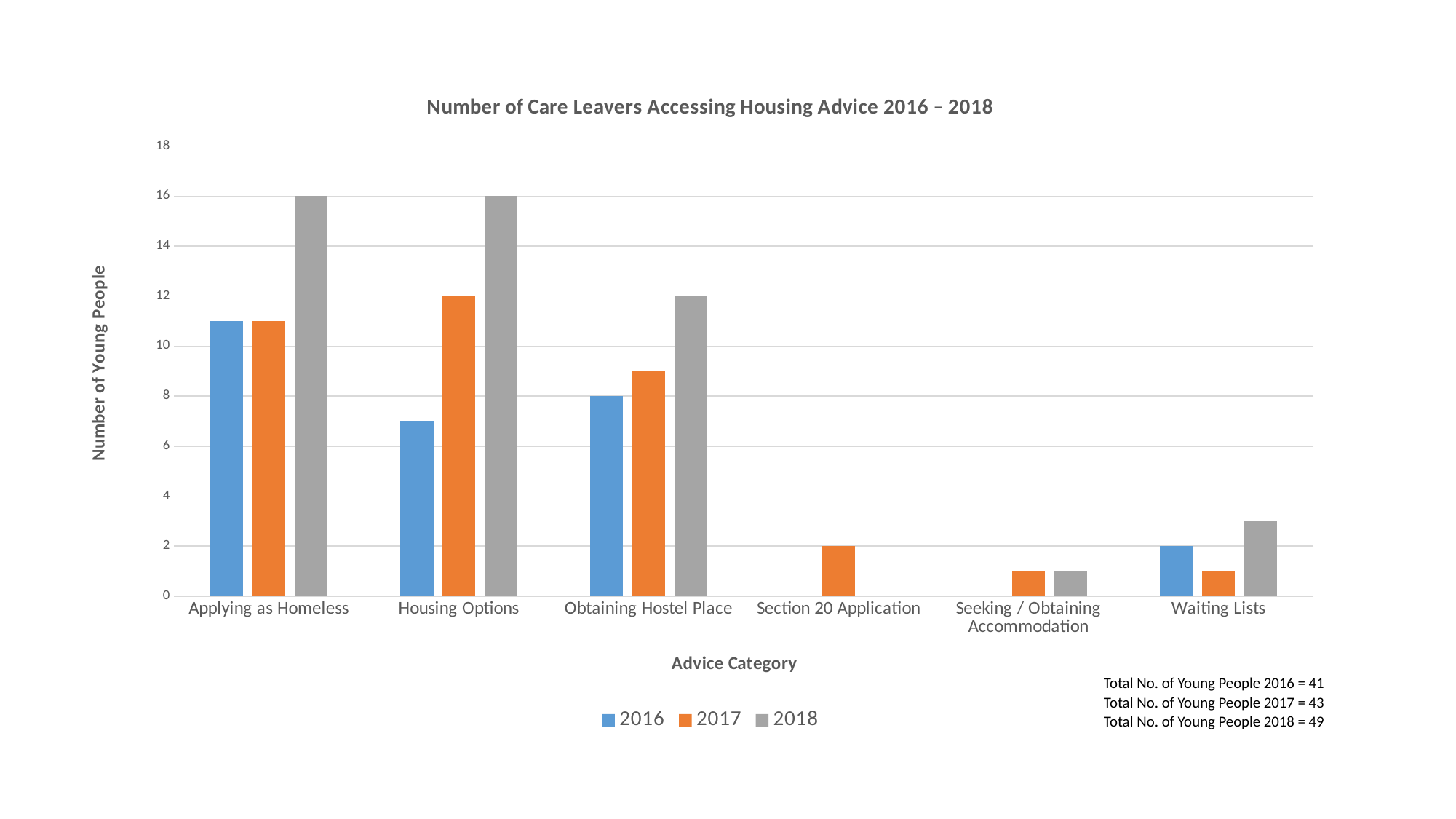
How many advice categories are shown on the x axis? 6 What is the value for 2017 in the Housing Options category? 12 Which year has the lowest value in the Obtaining Hostel Place category? 2016 What is the difference between the 2018 and 2016 values in the Obtaining Hostel Place category? 4 Which year has the highest value in the Housing Options category? 2018 What is the value for 2017 in the Section 20 Application category? 2 Is the value for 2018 in the Waiting Lists category greater or less than 4? less What is the value for 2018 in the Applying as Homeless category? 16 How many series does the legend list? 3 What type of chart is shown on the slide? bar chart What is the value for 2016 in the Obtaining Hostel Place category? 8 Is the value for 2016 in the Applying as Homeless category greater or less than 10? greater